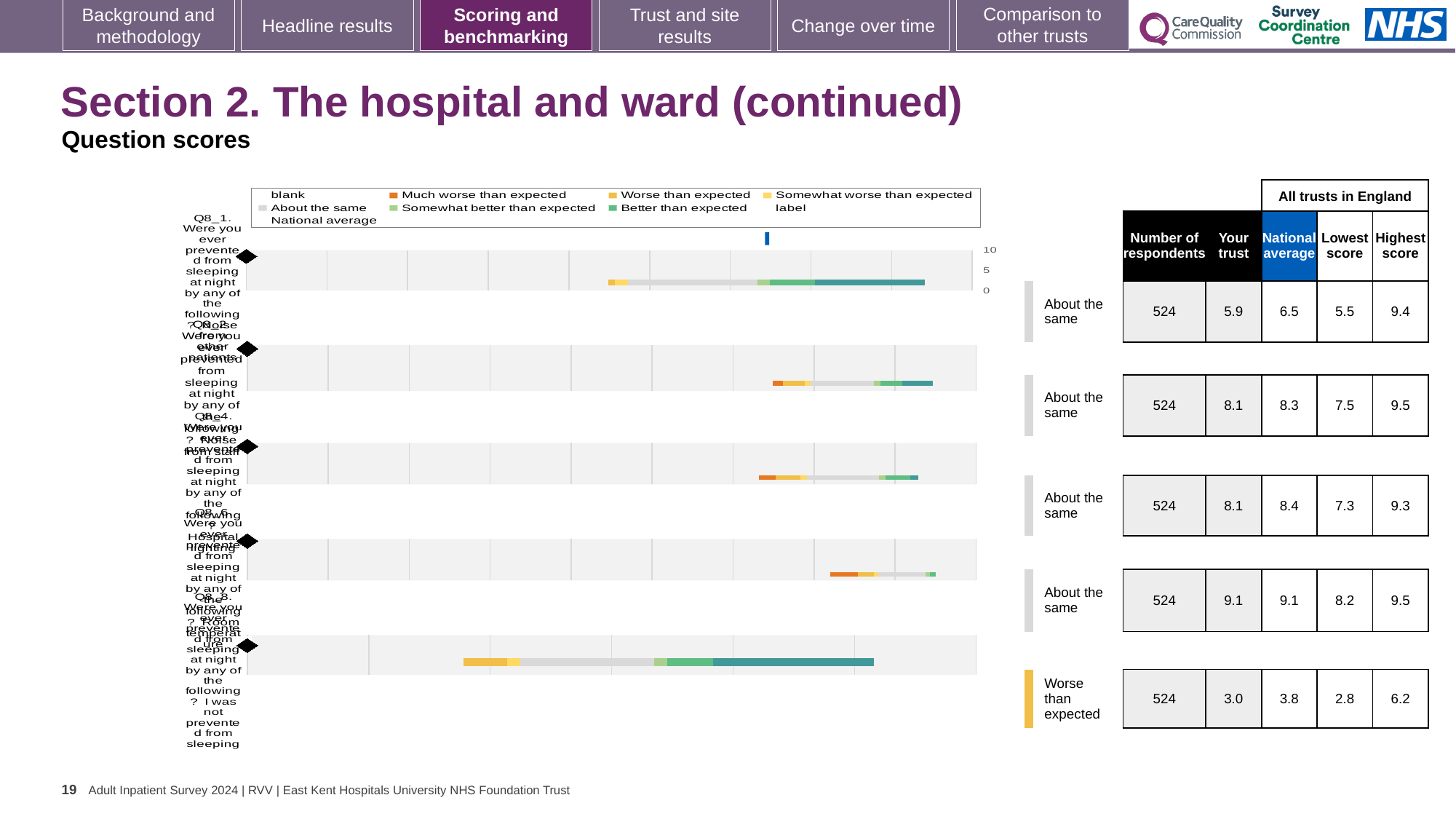
Which legend entry is shown in dark teal? Better than expected What is the 'Your trust' score for the first row (Q8_1)? 5.9 What is the national average for the row rated 'Worse than expected'? 3.8 What kind of chart is used to show the question scores on this slide? bar chart How many question rows (bars) are plotted in the chart? 5 How many question rows are rated 'About the same'? 4 What is the number of respondents shown for each question row? 524 Which is larger for Q8_1: the 'Your trust' score or the national average? National average How many entries does the chart legend list? 9 What is the 'Your trust' score for the row rated 'Worse than expected'? 3.0 Which legend entry is shown in orange? Much worse than expected Which question row is rated 'Worse than expected'? Q8_8